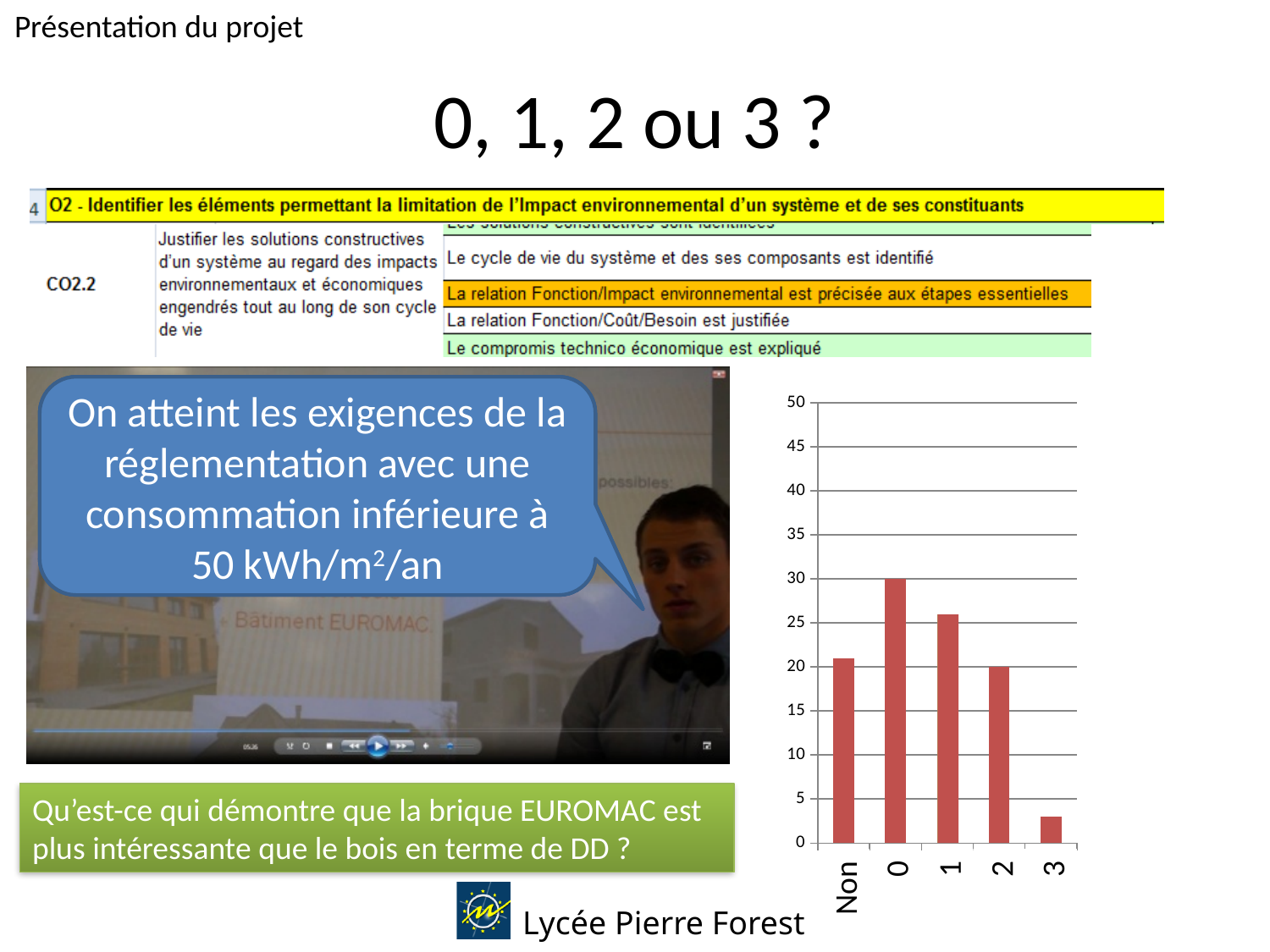
Is the value for category 3 greater or less than 5? less Is the value for category 0 greater or less than 25? greater Is the value for category 2 greater or less than 25? less What kind of chart is shown on the slide? bar chart Which category has the highest bar in the chart? 0 Which is larger, the bar for category 0 or the bar for category 2? 0 How many categories are shown on the x axis of the bar chart? 5 Which category has the lowest bar in the chart? 3 Do the bars rise or fall going from category 0 to category 3? fall What is the highest value shown on the y axis of the chart? 50